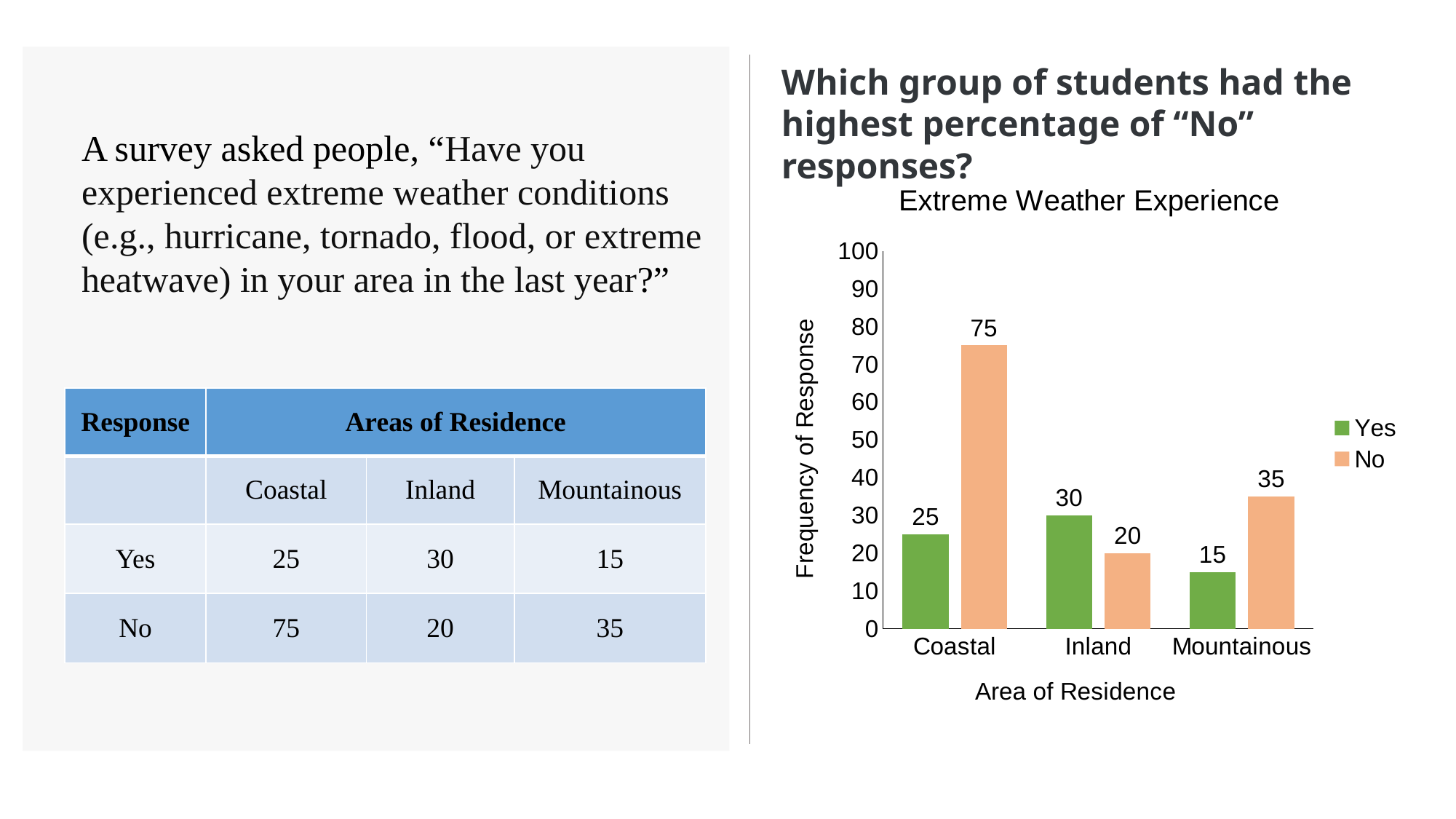
Which area of residence has the highest "No" value in the chart? Coastal How many series does the chart's legend list? 2 Is the "No" value for Mountainous greater or less than 30? greater What is the value of the "Yes" bar for Mountainous in the Extreme Weather Experience chart? 15 What is the value of the "No" bar for Inland in the Extreme Weather Experience chart? 20 What is the value of the "No" bar for Coastal in the Extreme Weather Experience chart? 75 How many areas of residence are shown on the x axis of the chart? 3 What is the title of the chart on the slide? Extreme Weather Experience Which is larger for Inland: the "Yes" value or the "No" value? Yes Which area of residence has the lowest "Yes" value in the chart? Mountainous What kind of chart is shown on the slide? Bar chart What is the difference between the "No" and "Yes" values for Coastal? 50